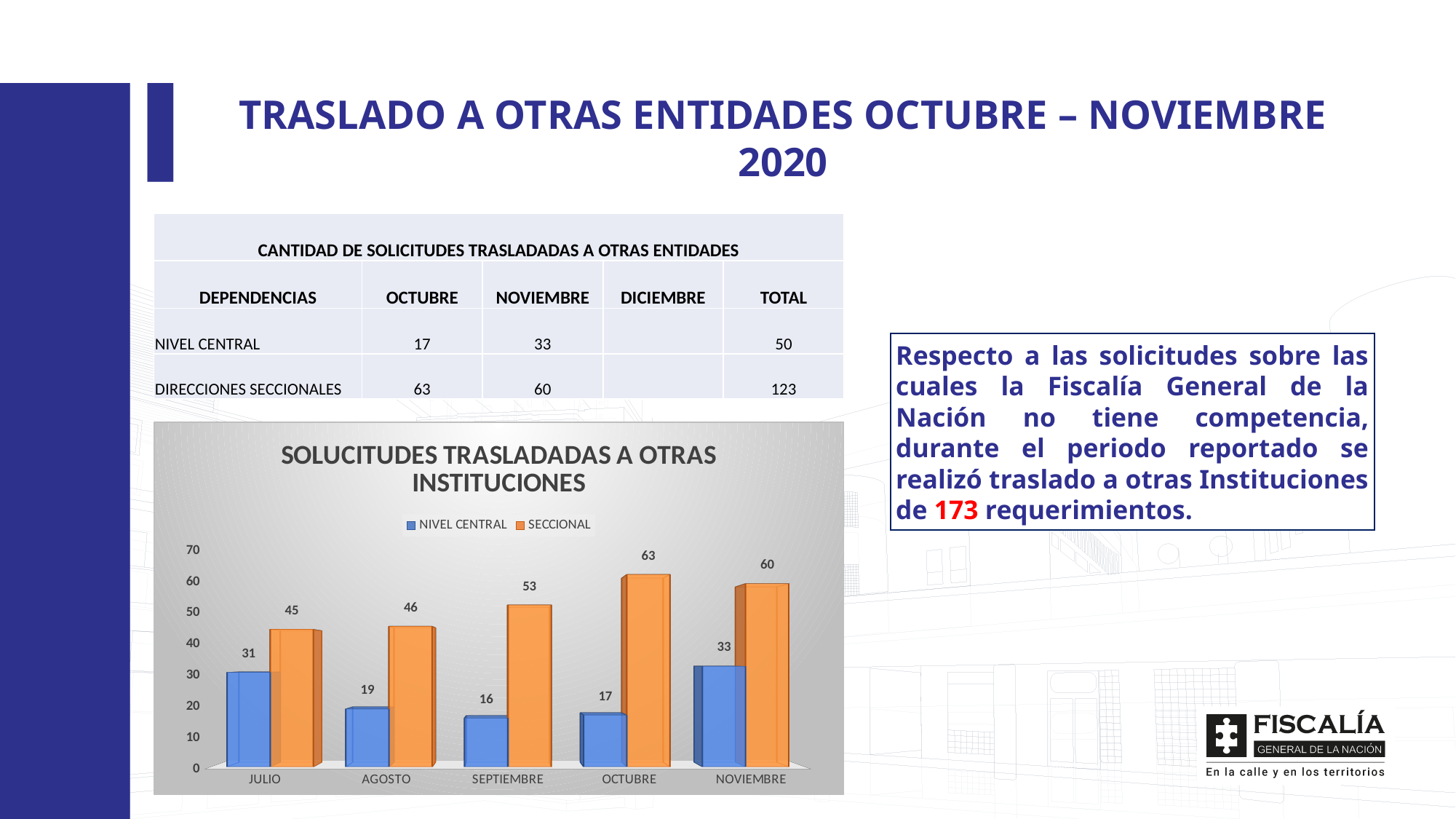
What kind of chart is shown on the slide? Bar chart What is the value for SECCIONAL in OCTUBRE? 63 What is the value for NIVEL CENTRAL in JULIO? 31 Is the SECCIONAL value for SEPTIEMBRE greater or less than 50? greater What is the difference between the SECCIONAL and NIVEL CENTRAL values in OCTUBRE? 46 What is the title of the chart? SOLUCITUDES TRASLADADAS A OTRAS INSTITUCIONES Which month has the lowest NIVEL CENTRAL value? SEPTIEMBRE How many series does the chart legend list? 2 Which month has the highest SECCIONAL value? OCTUBRE What is the value for NIVEL CENTRAL in NOVIEMBRE? 33 Which is larger in AGOSTO, NIVEL CENTRAL or SECCIONAL? SECCIONAL How many months are shown on the x axis of the chart? 5